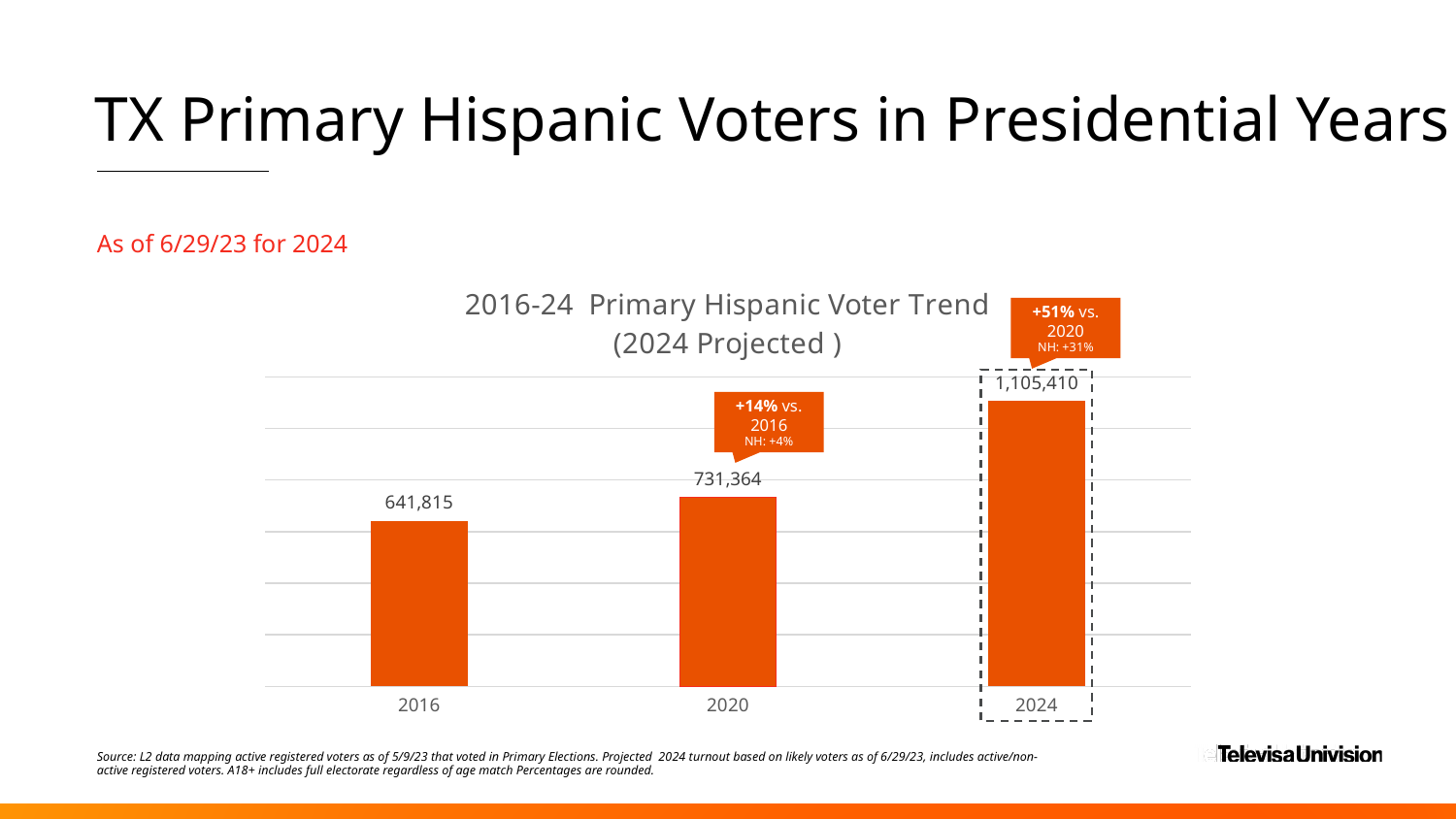
What percentage change vs. 2020 does the callout above the 2024 bar show? +51% What is the value for 2020? 731,364 What is the projected value for 2024? 1,105,410 What is the value for 2016? 641,815 How many years are shown on the x axis? 3 What is the difference between the 2024 and 2020 values? 374,046 Which year has the highest value? 2024 Do the values rise or fall from 2016 to 2024? Rise What kind of chart is this? Bar chart Which is larger, the value for 2020 or the value for 2016? 2020 What is the difference between the 2020 and 2016 values? 89,549 Which year has the lowest value? 2016